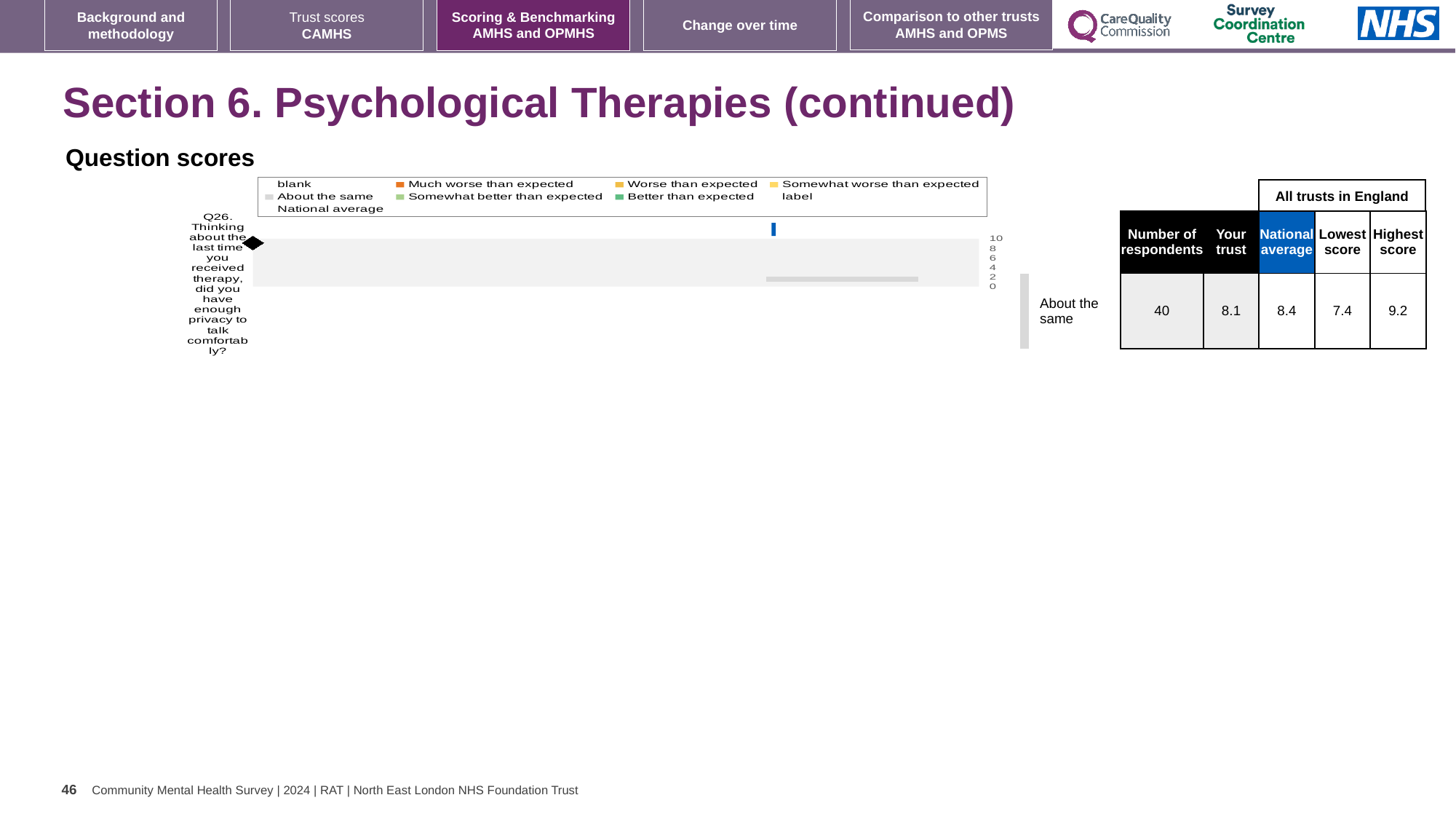
In the table beside the chart, what is the highest score among all trusts in England for Q26? 9.2 What colour does the legend use for 'Much worse than expected'? orange In the table beside the chart, what is the lowest score among all trusts in England for Q26? 7.4 In the table beside the chart, what is the 'Your trust' score for Q26? 8.1 In the table beside the chart, what is the number of respondents for Q26? 40 What is the difference between the highest score and the lowest score for Q26 in the table beside the chart? 1.8 Which is larger for Q26: the 'Your trust' score or the national average? National average What kind of chart is shown under 'Question scores'? bar chart How many questions (categories) are plotted in the chart? 1 In the table beside the chart, what is the national average score for Q26? 8.4 What benchmark category is given for Q26 next to the chart? About the same Which question is plotted in the chart? Q26. Thinking about the last time you received therapy, did you have enough privacy to talk comfortably?